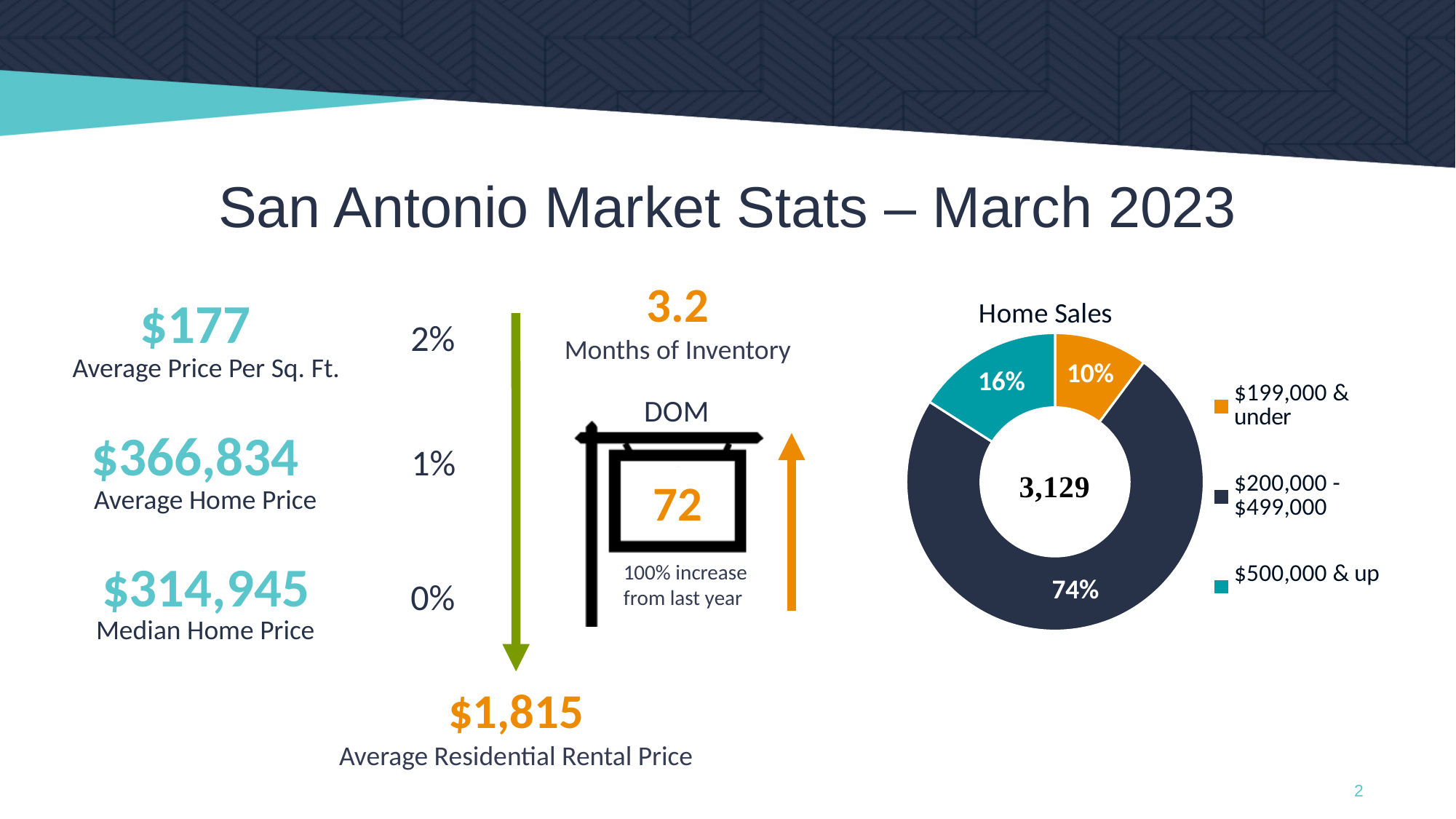
What kind of chart is the Home Sales chart? Pie (donut) chart In the Home Sales chart, what share of sales is in the $500,000 & up category? 16% In the Home Sales chart, what is the difference between the $200,000 - $499,000 share and the $500,000 & up share? 58% In the Home Sales chart, which is larger: the $500,000 & up share or the $199,000 & under share? $500,000 & up How many price categories does the Home Sales chart show? 3 In the Home Sales chart, what is the difference between the $500,000 & up share and the $199,000 & under share? 6% What is the title of the donut chart on the slide? Home Sales Which price category has the smallest share in the Home Sales chart? $199,000 & under Which price category has the largest share in the Home Sales chart? $200,000 - $499,000 In the Home Sales chart, what share of sales is in the $199,000 & under category? 10% What number is shown in the center of the Home Sales donut chart? 3,129 In the Home Sales chart, what share of sales is in the $200,000 - $499,000 category? 74%